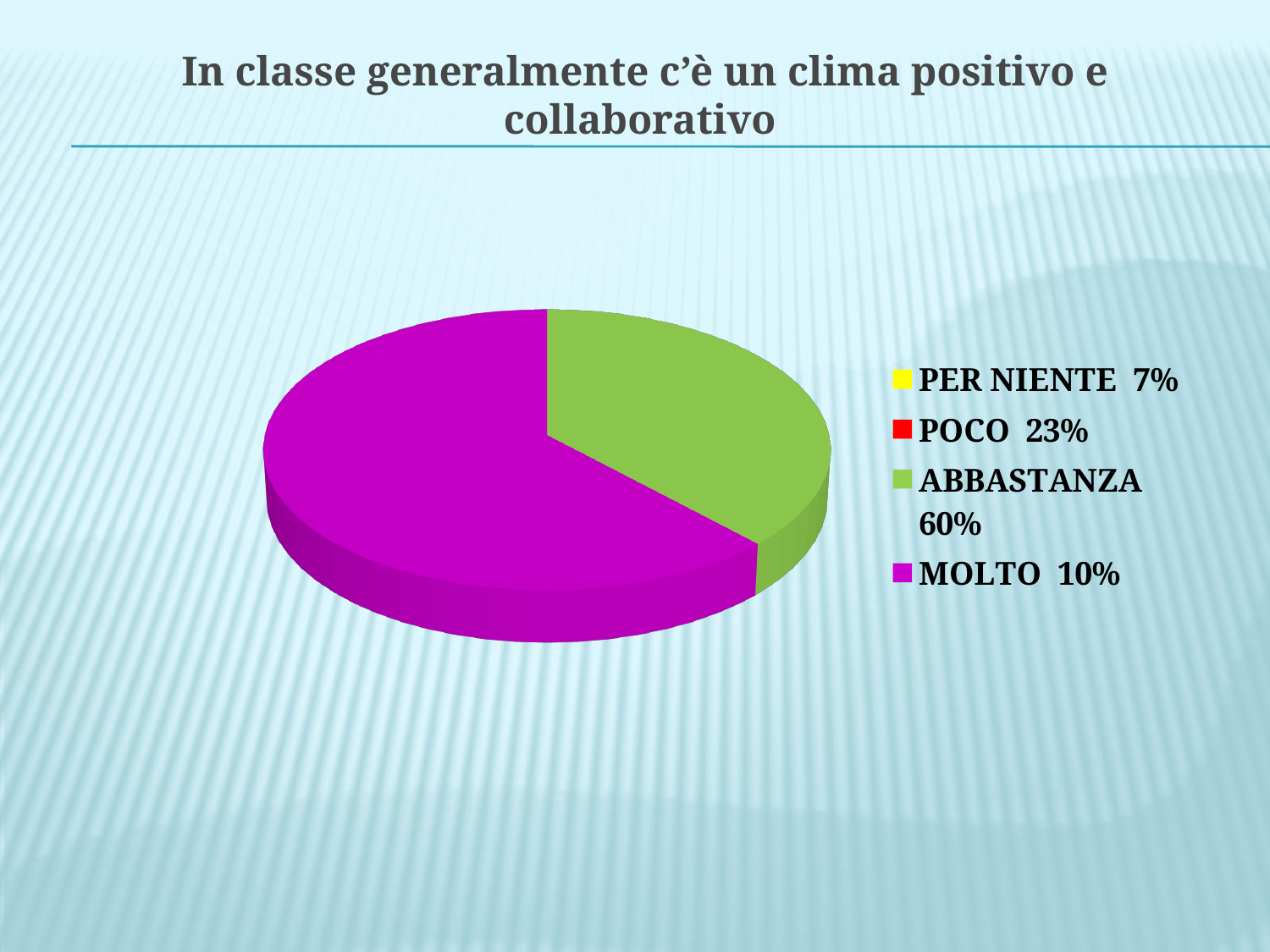
What kind of chart is shown on the slide? pie chart How many categories does the legend list? 4 What percentage is shown in the legend for POCO? 23% What colour is used for the ABBASTANZA category in the legend? green What percentage is shown in the legend for PER NIENTE? 7% What is the difference between the legend percentages for MOLTO and PER NIENTE? 3% What is the difference between the legend percentages for ABBASTANZA and POCO? 37% What percentage is shown in the legend for MOLTO? 10% What is the title of the chart? In classe generalmente c'è un clima positivo e collaborativo What percentage is shown in the legend for ABBASTANZA? 60%